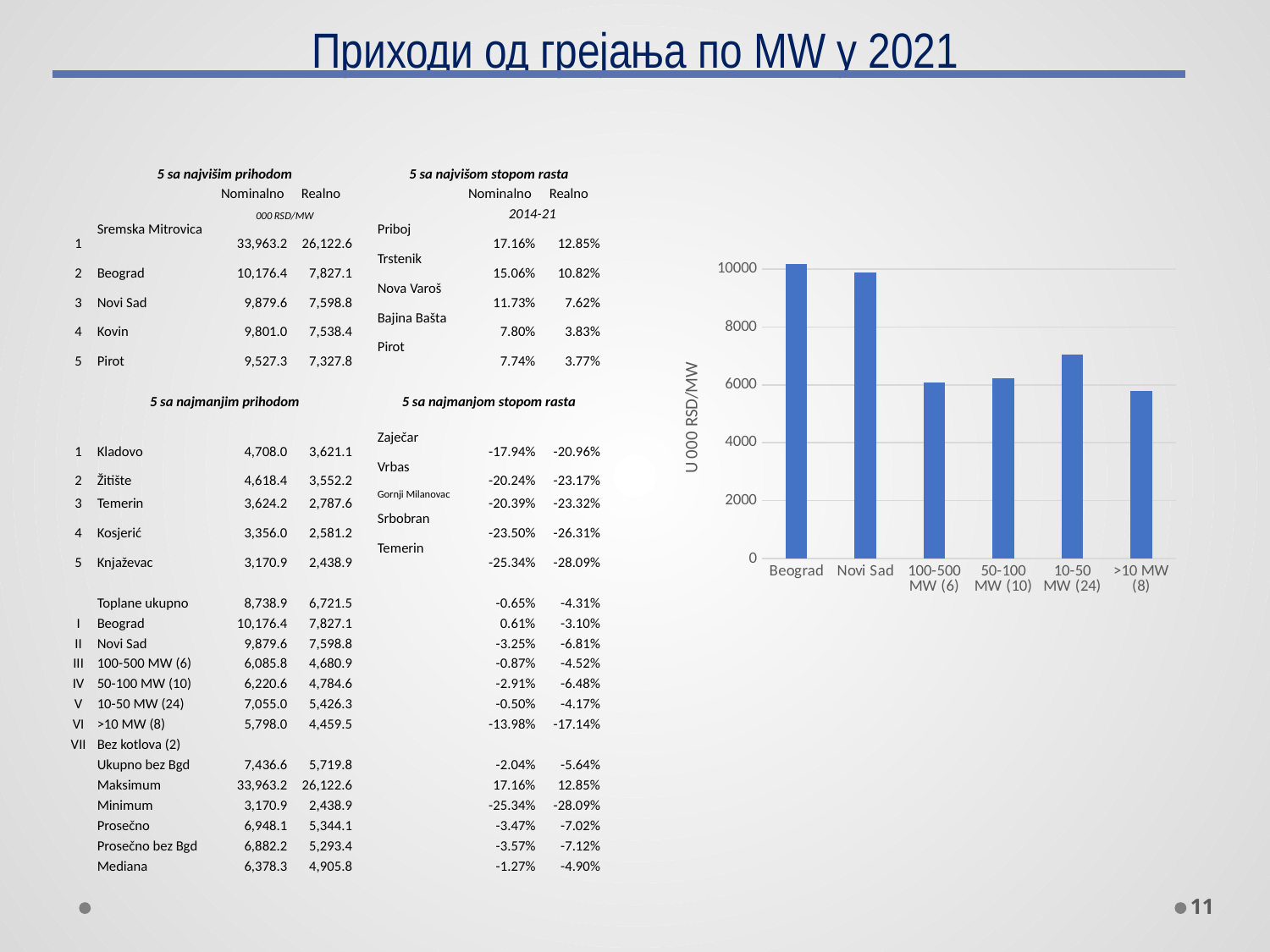
What kind of chart is shown on the right side of the slide? bar chart How many categories are shown on the x axis of the bar chart? 6 Is the value for 50-100 MW (10) in the chart greater or less than 8000? less In the chart, which is larger: the value for Beograd or the value for Novi Sad? Beograd What is the label of the vertical axis of the chart? U 000 RSD/MW Which category has the lowest bar in the chart? >10 MW (8) Is the value for 10-50 MW (24) in the chart greater or less than 6000? greater Is the value for Novi Sad in the chart greater or less than 10000? less In the chart, which is larger: the value for 10-50 MW (24) or the value for >10 MW (8)? 10-50 MW (24) Which category has the highest bar in the chart? Beograd